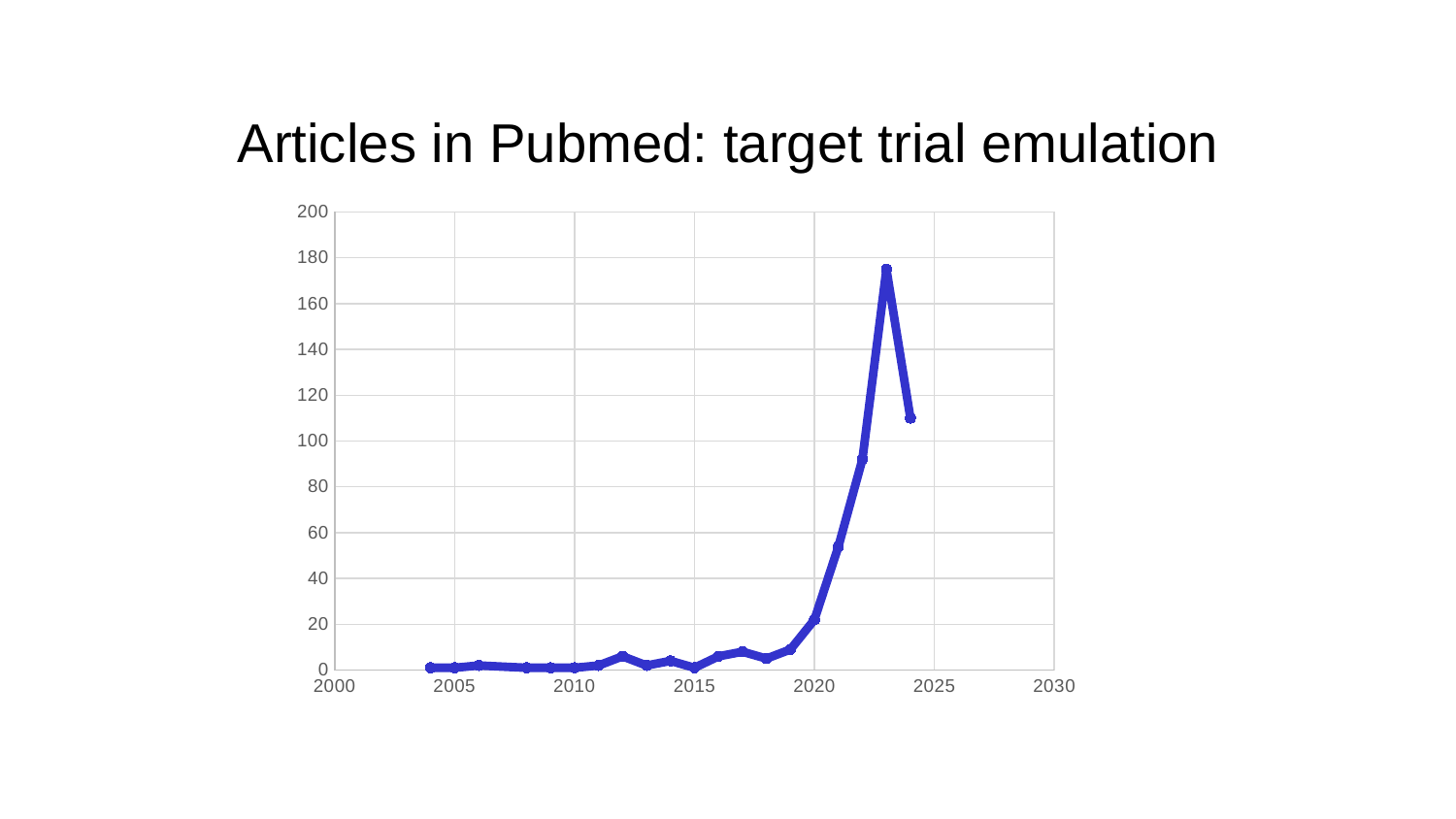
Is the value for 2021 greater or less than 40? greater Is the value for 2024 greater or less than 100? greater Overall, do the values rise or fall from 2004 to 2023? rise In which year does the line reach its highest value? 2023 What kind of chart is shown on the slide? line chart Which year has the larger value, 2021 or 2022? 2022 What is the title of the chart? Articles in Pubmed: target trial emulation Is the value for 2022 greater or less than 100? less What colour is the plotted line? blue Which year has the larger value, 2023 or 2024? 2023